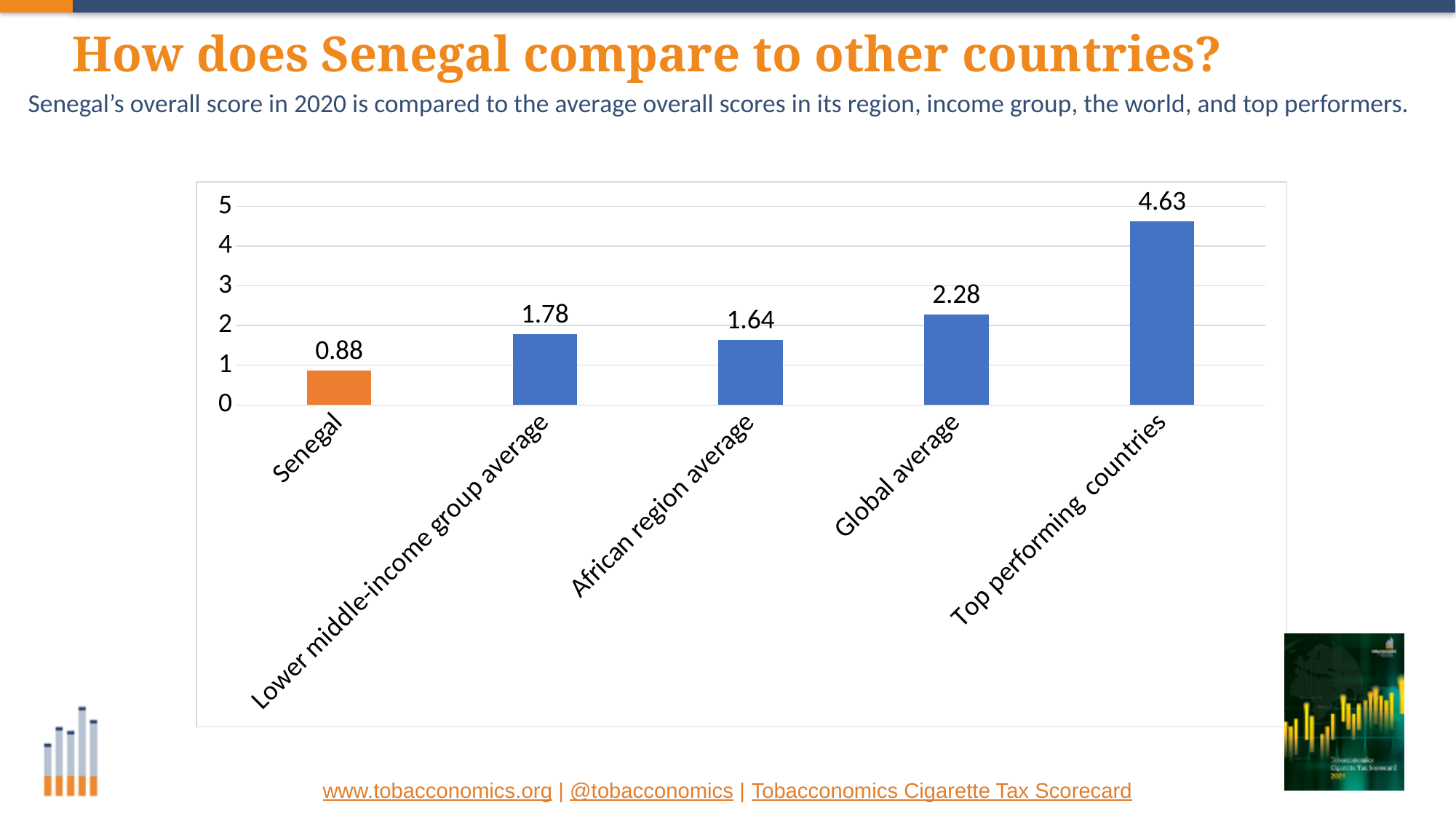
Which is larger, the Lower middle-income group average or the African region average? Lower middle-income group average What is the value shown for the Lower middle-income group average? 1.78 What is the difference between the Global average and the African region average? 0.64 What is the difference between the value for Top performing countries and the value for Senegal? 3.75 What is the value shown for the Global average? 2.28 What is the overall score shown for Senegal? 0.88 How many categories are shown on the x axis? 5 What is the value shown for the African region average? 1.64 What kind of chart is shown on the slide? Bar chart Which category has the highest value? Top performing countries Is the value for Senegal greater or less than 1? less Which category has the lowest value? Senegal